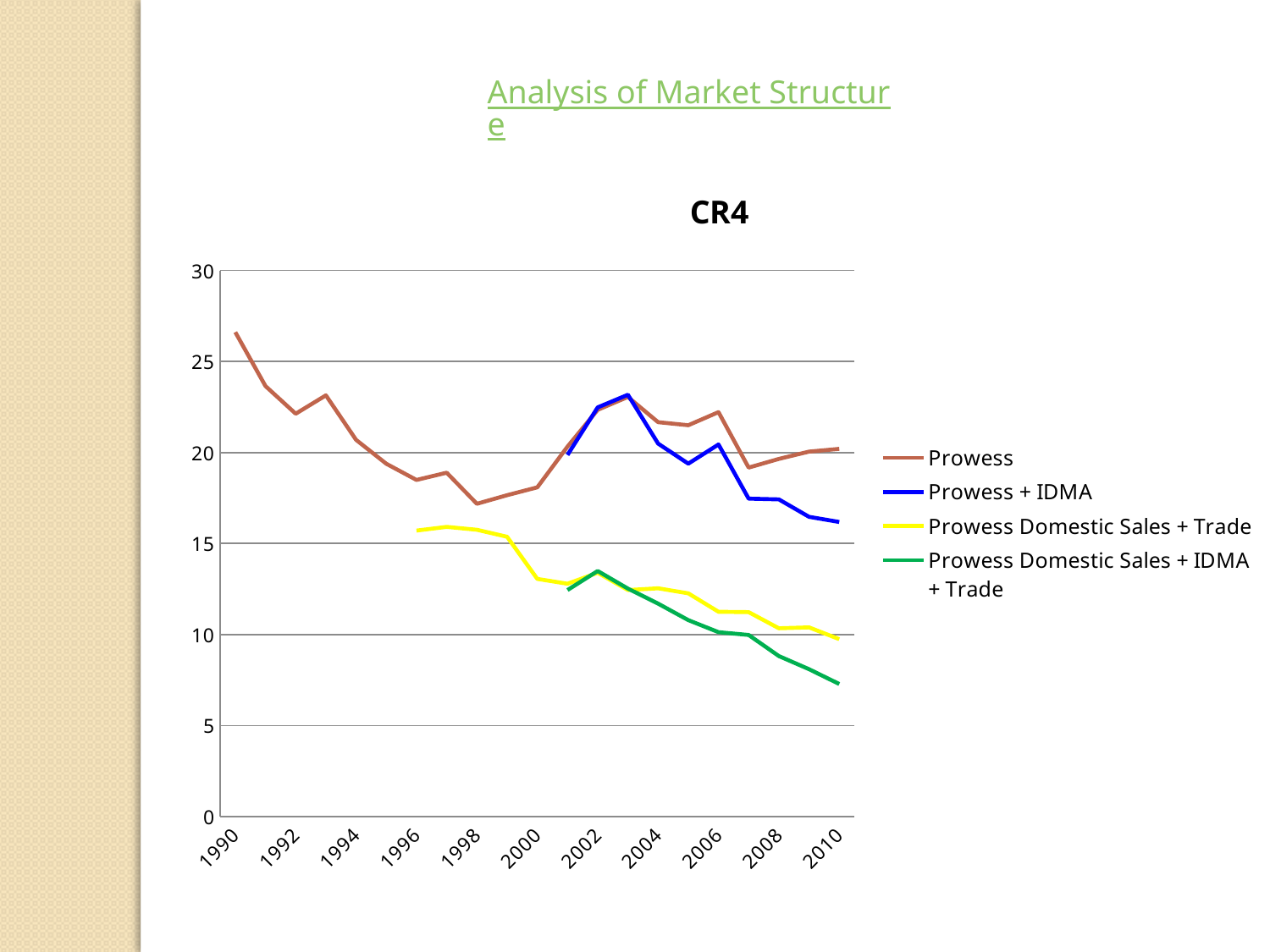
What is the title of the chart? CR4 Is the value of the Prowess Domestic Sales + IDMA + Trade series in 2010 greater or less than 10? less In 2010, which is higher: Prowess or Prowess + IDMA? Prowess Is the value of the Prowess series in 1998 greater or less than 20? less Is the value of the Prowess series in 1990 greater or less than 25? greater Which series in the CR4 chart is drawn in blue? Prowess + IDMA Does the Prowess Domestic Sales + IDMA + Trade series rise or fall from 2002 to 2010? Fall How many series does the legend of the CR4 chart list? 4 Which series has the highest value in 2010? Prowess What kind of chart is shown on the slide? Line chart Which series has the lowest value in 2010? Prowess Domestic Sales + IDMA + Trade